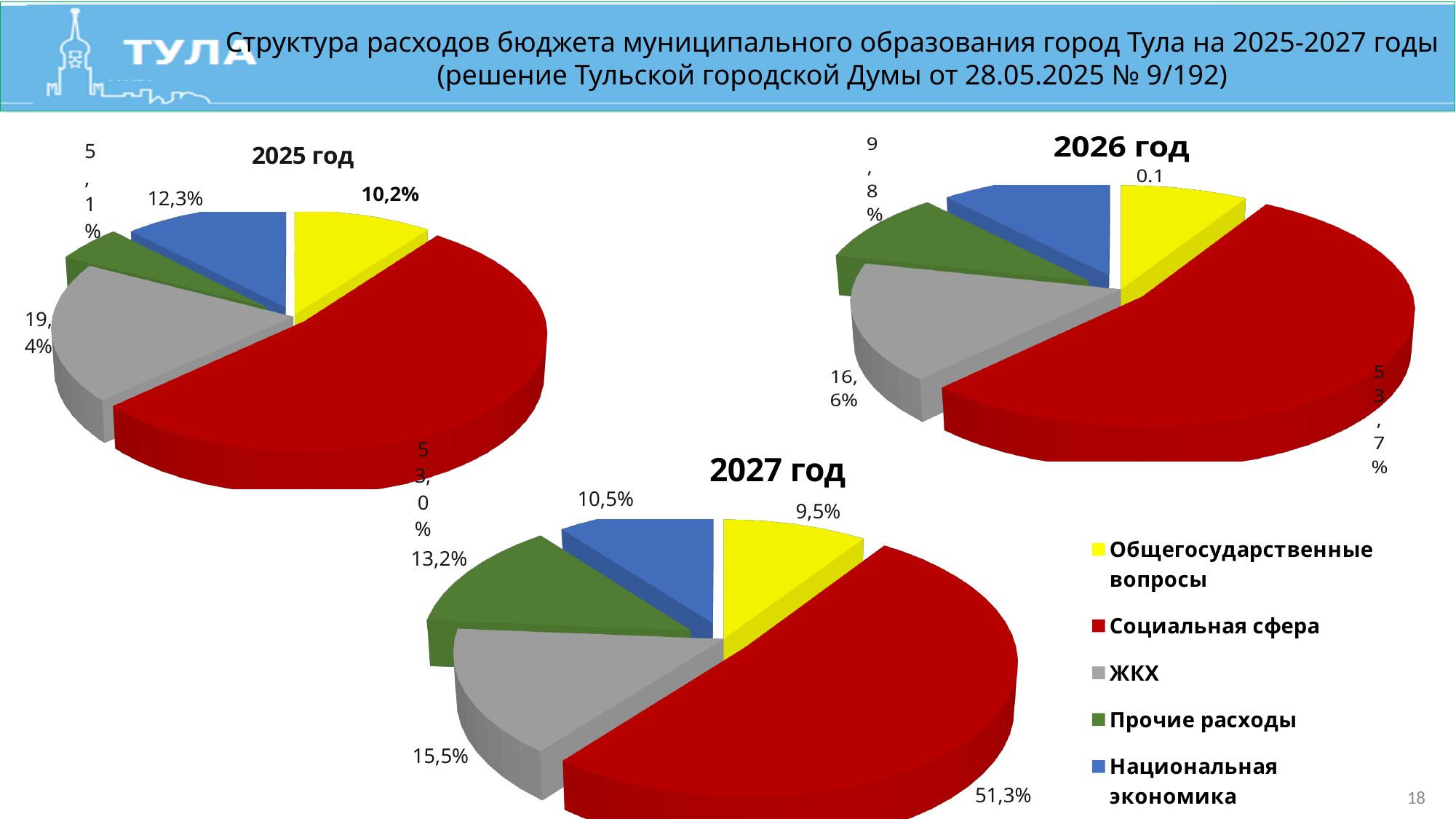
In the 2027 год pie chart, what share is shown for Социальная сфера? 51,3% How many categories does the legend list for the pie charts? 5 In the 2025 год pie chart, what share is shown for ЖКХ? 19,4% What type of chart is used for the 2027 год data? Pie chart In the 2026 год pie chart, what share is shown for Социальная сфера? 53,7% In the 2027 год pie chart, which is larger: the share for ЖКХ or the share for Национальная экономика? ЖКХ In the 2025 год pie chart, what share is shown for Национальная экономика? 12,3% In the 2027 год pie chart, what share is shown for Прочие расходы? 13,2% In the 2025 год pie chart, what share is shown for Социальная сфера? 53,0% In the 2025 год pie chart, what is the difference between the shares of Социальная сфера and ЖКХ? 33,6% In the 2026 год pie chart, what share is shown for ЖКХ? 16,6% In the 2025 год pie chart, which category has the smallest slice? Прочие расходы